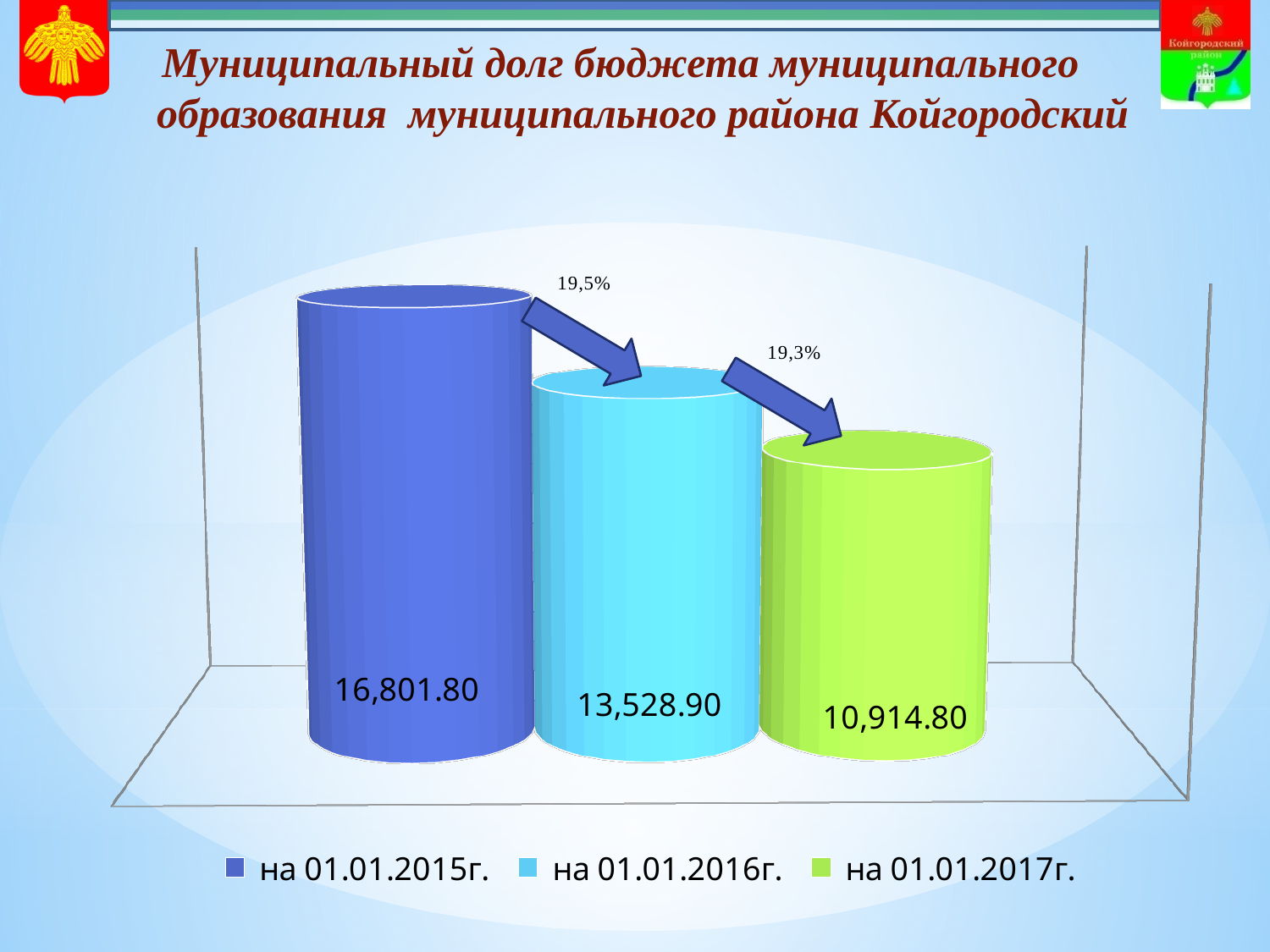
What is the municipal debt value shown for на 01.01.2016г.? 13,528.90 What is the difference between the values for на 01.01.2016г. and на 01.01.2017г.? 2,614.10 What is the municipal debt value shown for на 01.01.2015г.? 16,801.80 Which is larger, the value for на 01.01.2016г. or the value for на 01.01.2017г.? на 01.01.2016г. What is the difference between the values for на 01.01.2015г. and на 01.01.2016г.? 3,272.90 Which date has the highest municipal debt value? на 01.01.2015г. What is the municipal debt value shown for на 01.01.2017г.? 10,914.80 What kind of chart is shown on the slide? bar chart Which date has the lowest municipal debt value? на 01.01.2017г. Do the municipal debt values rise or fall from 01.01.2015 to 01.01.2017? fall How many entries does the legend list? 3 How many bars are plotted on the chart? 3